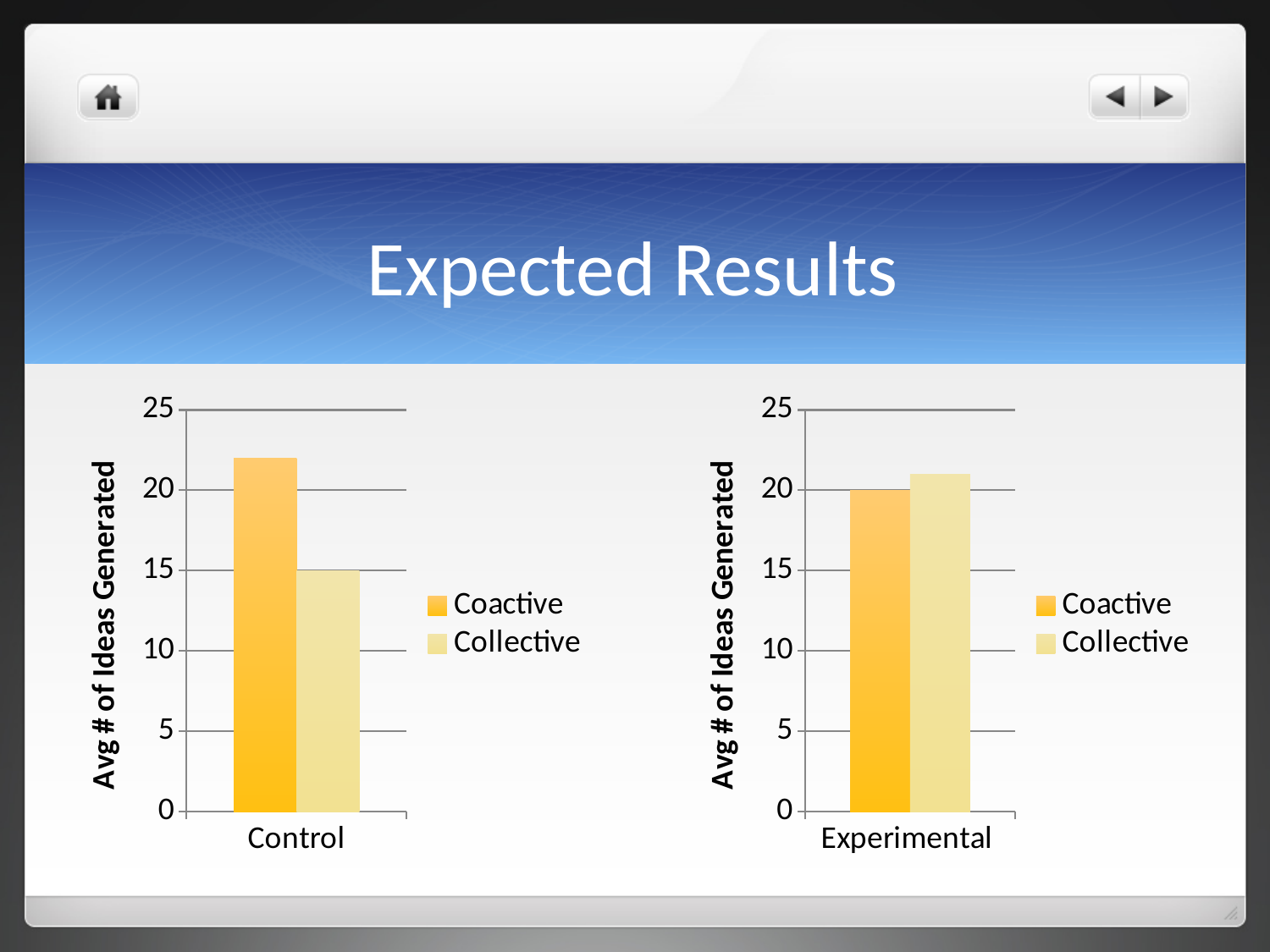
How many categories are shown on the x axis of the Experimental chart? 1 How many series does the legend of the Experimental chart list? 2 On the Experimental chart, is the value for Collective greater or less than 25? less On the Control chart, what is the value for Collective? 15 On the Control chart, which series has the lowest value? Collective On the Control chart, is the value for Collective greater or less than 20? less What is the y-axis label on the Control chart? Avg # of Ideas Generated On the Experimental chart, what is the value for Coactive? 20 What kind of chart is the Control chart? bar chart On the Control chart, which series has the higher value, Coactive or Collective? Coactive On the Control chart, is the value for Coactive greater or less than 20? greater On the Experimental chart, which series is shown in the darker orange colour? Coactive